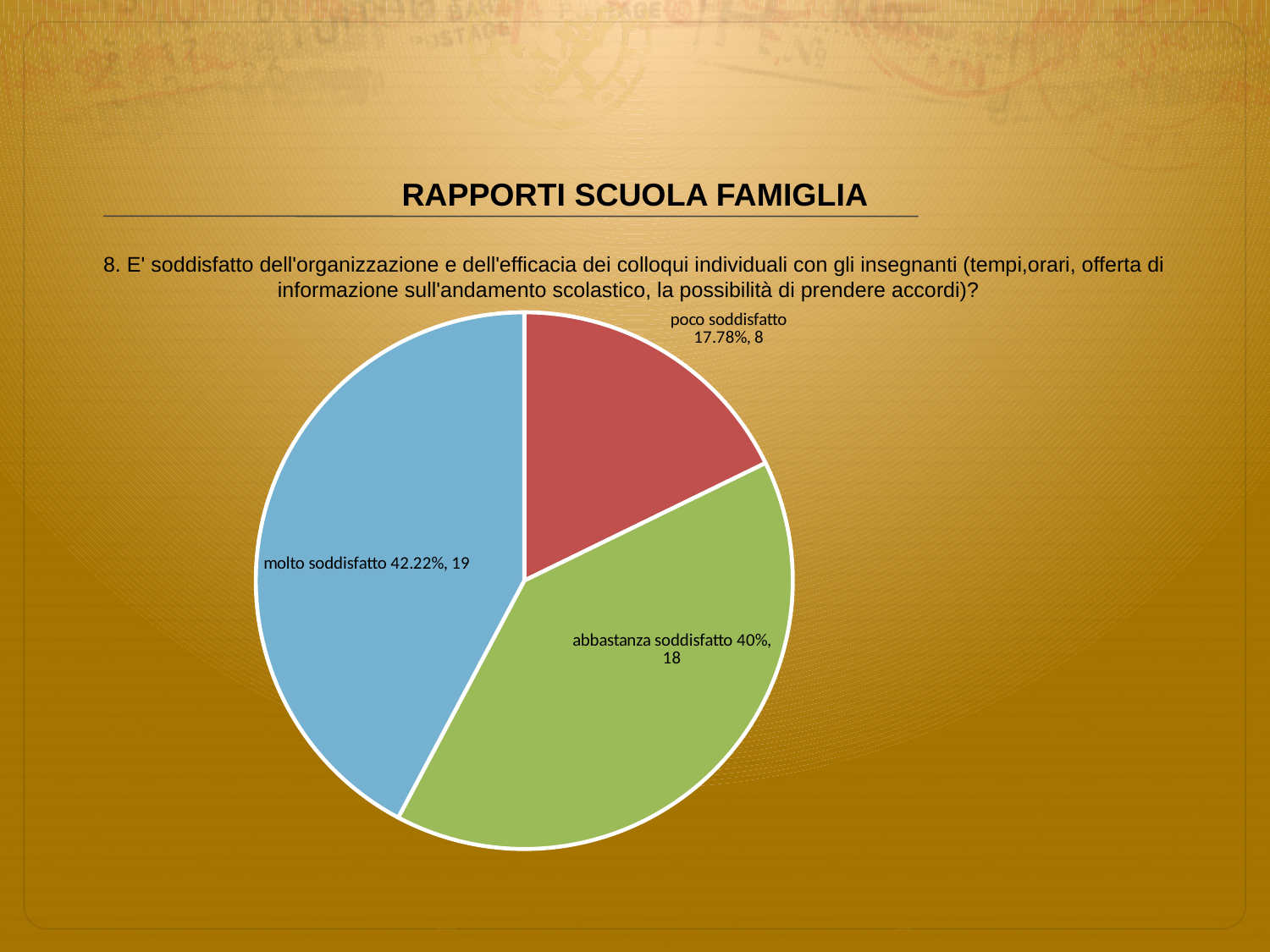
What colour is the 'abbastanza soddisfatto' slice? green Which category has the largest slice of the pie? molto soddisfatto What percentage share does the 'molto soddisfatto' slice have? 42.22% What kind of chart is shown on the slide? pie chart How many slices does the pie chart have? 3 How many respondents answered 'molto soddisfatto'? 19 Which category has the smallest slice of the pie? poco soddisfatto What is the difference in respondent count between 'molto soddisfatto' and 'poco soddisfatto'? 11 What percentage share does the 'poco soddisfatto' slice have? 17.78% What percentage share does the 'abbastanza soddisfatto' slice have? 40% How many respondents answered 'poco soddisfatto'? 8 How many respondents answered 'abbastanza soddisfatto'? 18